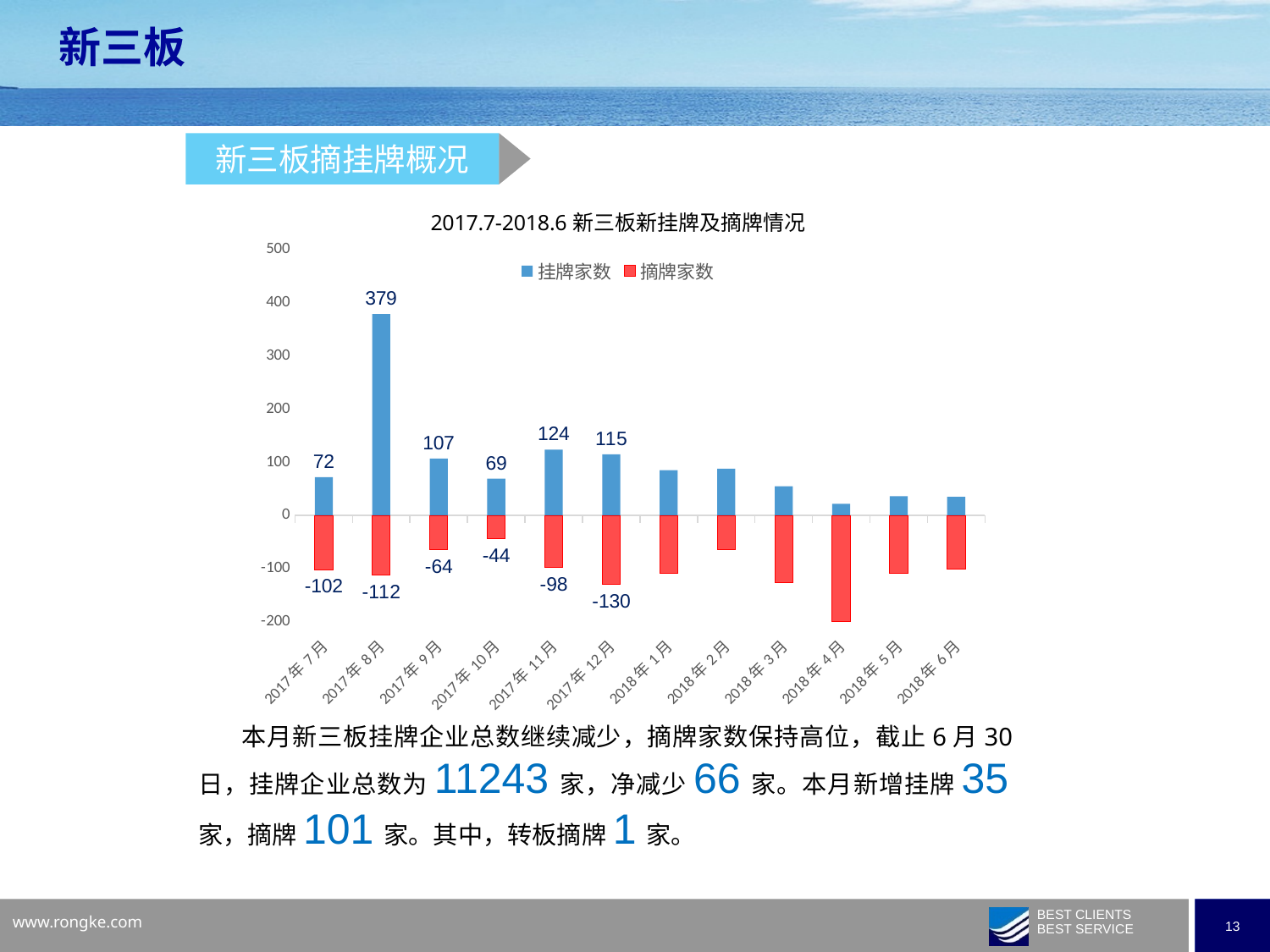
Is the 挂牌家数 value for 2018年1月 greater or less than 100? less What is the 摘牌家数 value for 2017年12月? -130 How many months are shown on the x axis of the chart? 12 What is the 摘牌家数 value for 2017年10月? -44 Which month has the lowest 挂牌家数? 2018年4月 What is the 挂牌家数 value for 2017年8月? 379 Which month has the larger 挂牌家数, 2017年11月 or 2017年12月? 2017年11月 What is the difference between the 挂牌家数 for 2017年8月 and 2017年7月? 307 How many series does the chart's legend list? 2 Which month has the highest 挂牌家数? 2017年8月 What is the title of the chart? 2017.7-2018.6 新三板新挂牌及摘牌情况 What kind of chart is shown on the slide? bar chart